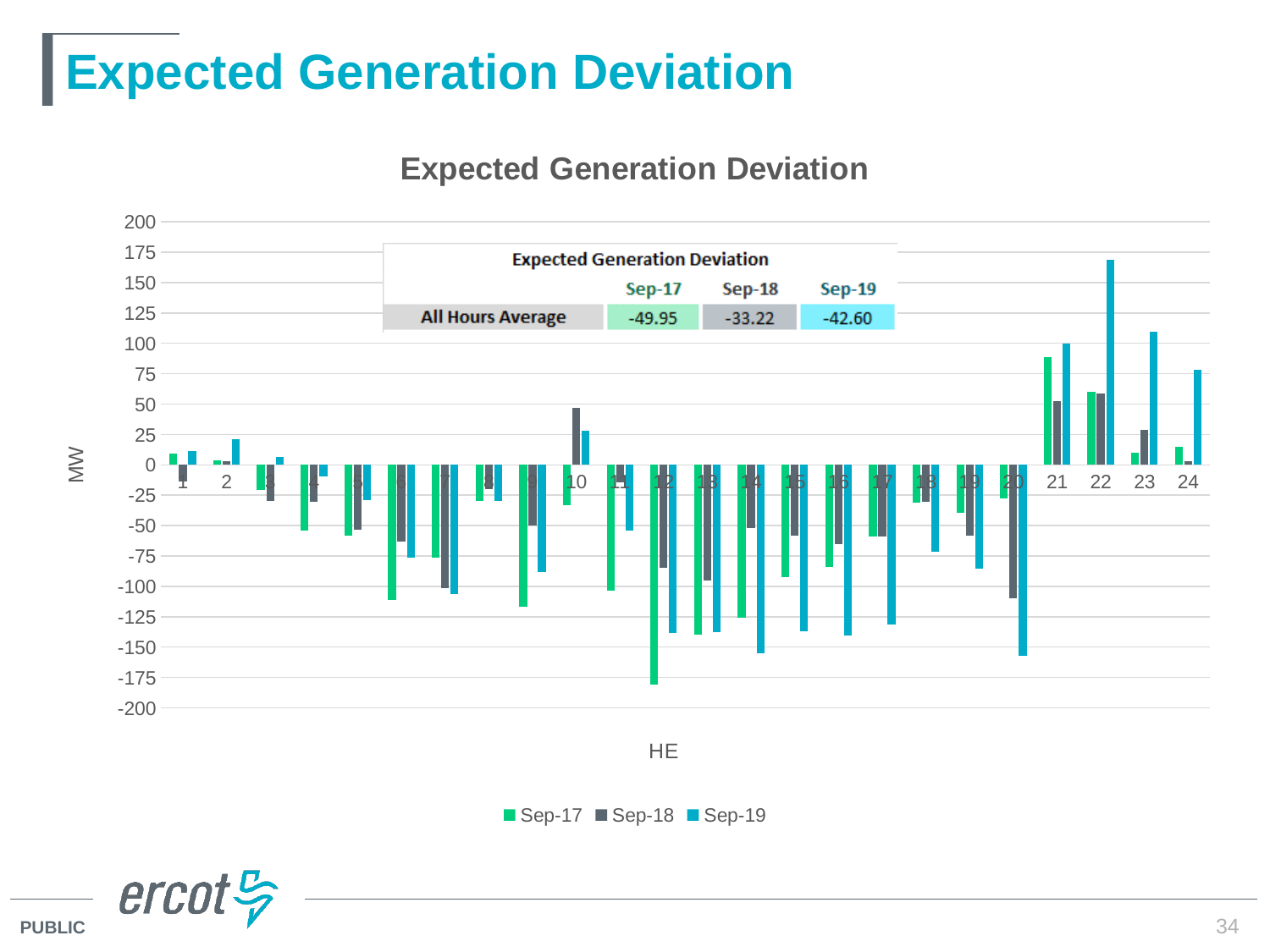
At HE 22, which is larger: the Sep-19 value or the Sep-17 value? Sep-19 What is the All Hours Average for Sep-19 shown in the inset table? -42.60 What is the difference between the All Hours Average for Sep-18 and Sep-17 in the inset table? 16.73 What kind of chart is shown on the slide? Bar chart How many hour-ending (HE) categories are shown on the x axis? 24 How many series does the legend list? 3 What is the All Hours Average for Sep-17 shown in the inset table? -49.95 Which series has the highest All Hours Average in the inset table? Sep-18 Is the Sep-17 value at HE 12 greater or less than -150? less What is the All Hours Average for Sep-18 shown in the inset table? -33.22 What is the label on the vertical axis? MW Is the Sep-19 value at HE 22 greater or less than 150? greater